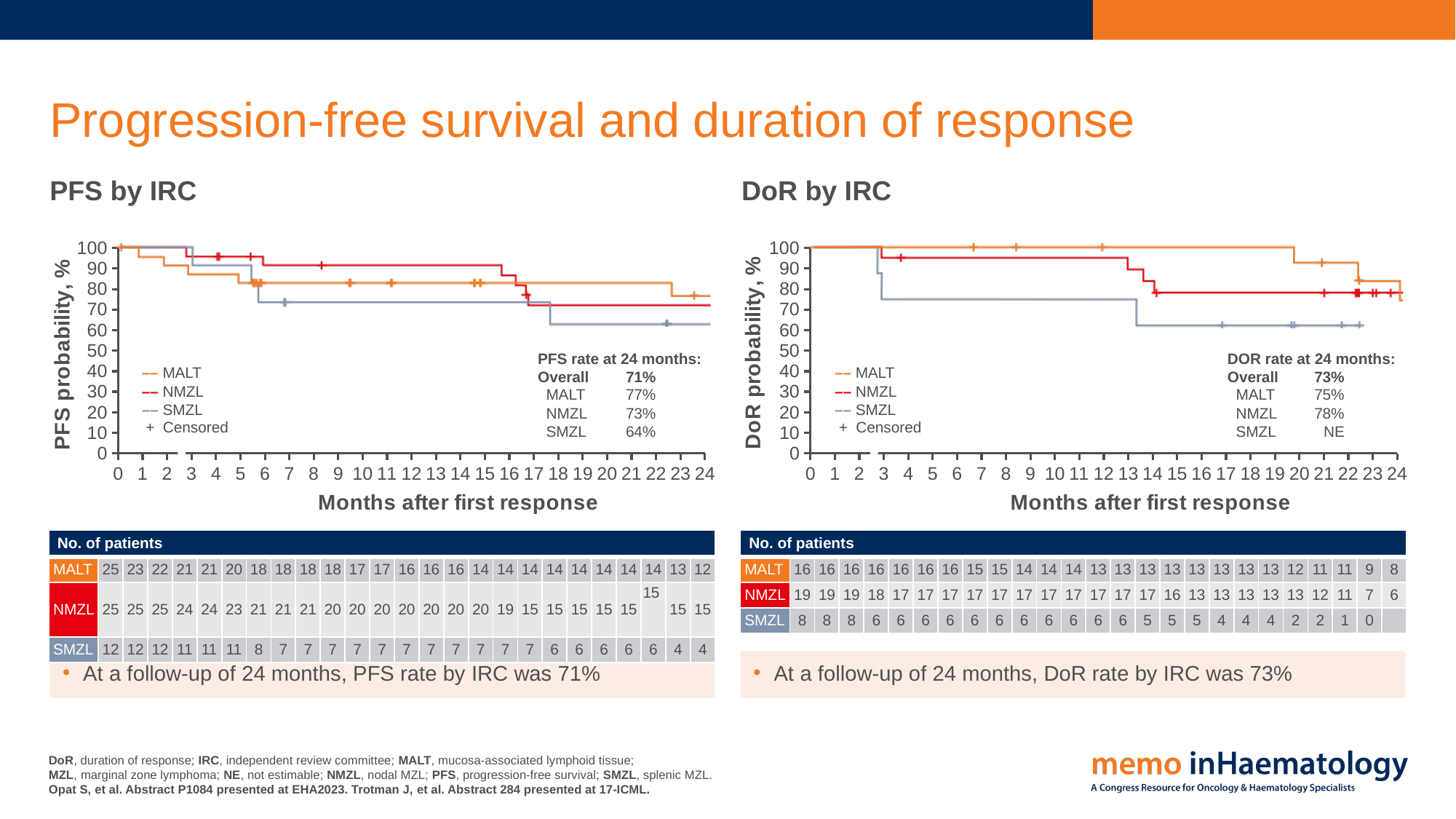
In the PFS by IRC chart, which subgroup has the lowest PFS rate at 24 months? SMZL In the DoR by IRC chart, what is the DOR rate at 24 months for the NMZL subgroup? 78% In the PFS by IRC chart, what is the PFS rate at 24 months for the MALT subgroup? 77% In the PFS by IRC chart, what is the overall PFS rate at 24 months? 71% What kind of chart is the DoR by IRC chart? Line chart (Kaplan-Meier survival curve) In the DoR by IRC chart, which subgroup has a higher DOR rate at 24 months, MALT or NMZL? NMZL In the PFS by IRC chart, is the SMZL curve at month 20 greater or less than 70%? less In the DoR by IRC chart, is the MALT curve at month 18 greater or less than 90%? greater In the DoR by IRC chart, what is the DOR rate at 24 months for the SMZL subgroup? NE How many subgroup curves does the legend of the PFS by IRC chart list? 3 In the PFS by IRC chart, what is the difference between the MALT and SMZL PFS rates at 24 months? 13% What is the x-axis label of the PFS by IRC chart? Months after first response